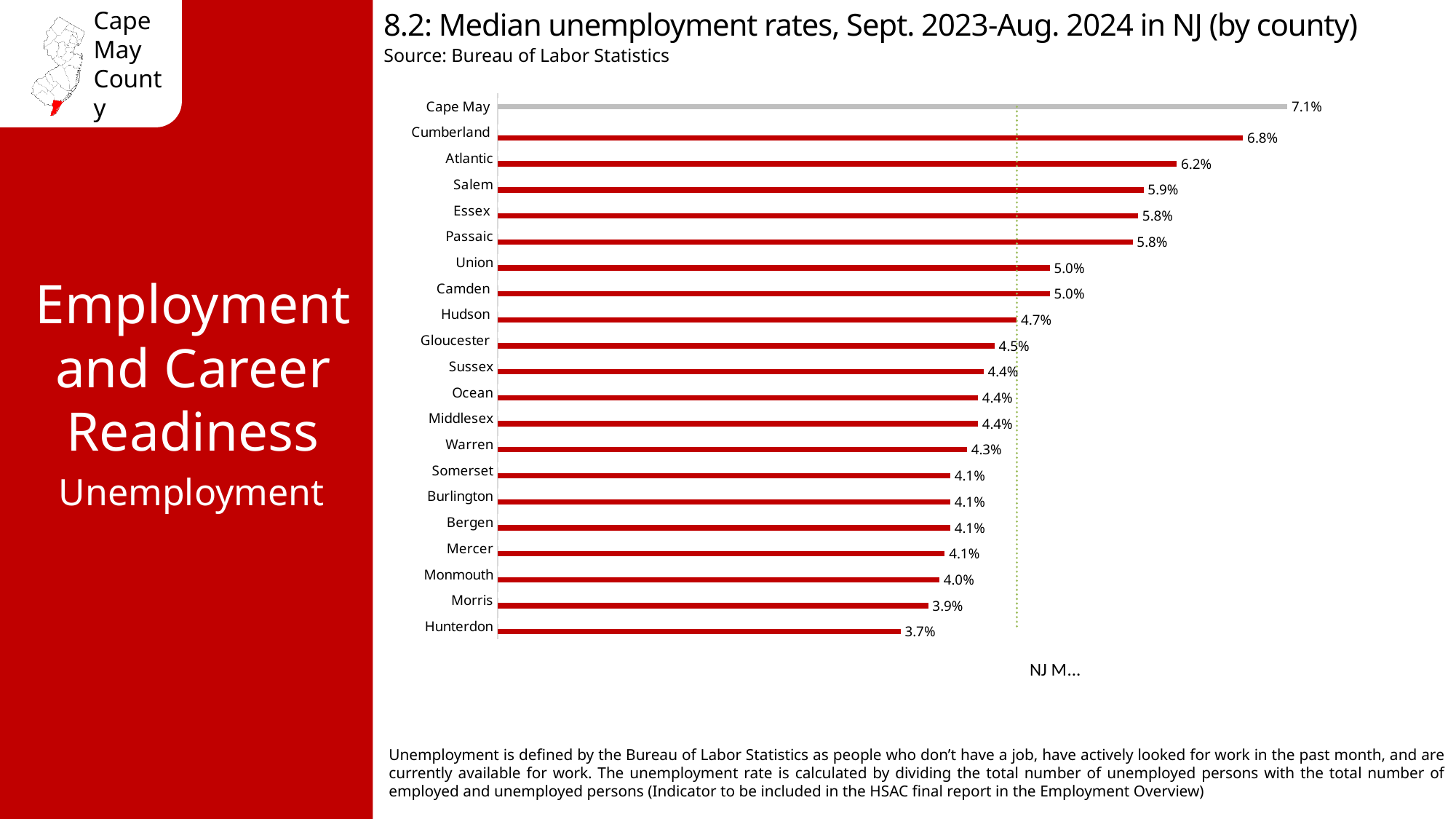
What is the difference between the median unemployment rates of Salem and Hunterdon? 2.2% Which county has a higher median unemployment rate, Essex or Union? Essex What is the median unemployment rate for Hudson? 4.7% Which county has the highest median unemployment rate? Cape May What is the median unemployment rate for Atlantic? 6.2% What is the median unemployment rate for Cape May? 7.1% How many counties are shown in the chart? 21 What is the difference between the median unemployment rates of Cape May and Cumberland? 0.3% What type of chart is used on this slide? Bar chart Which county has the lowest median unemployment rate? Hunterdon What is the median unemployment rate for Morris? 3.9% Which county's bar is coloured grey instead of red? Cape May